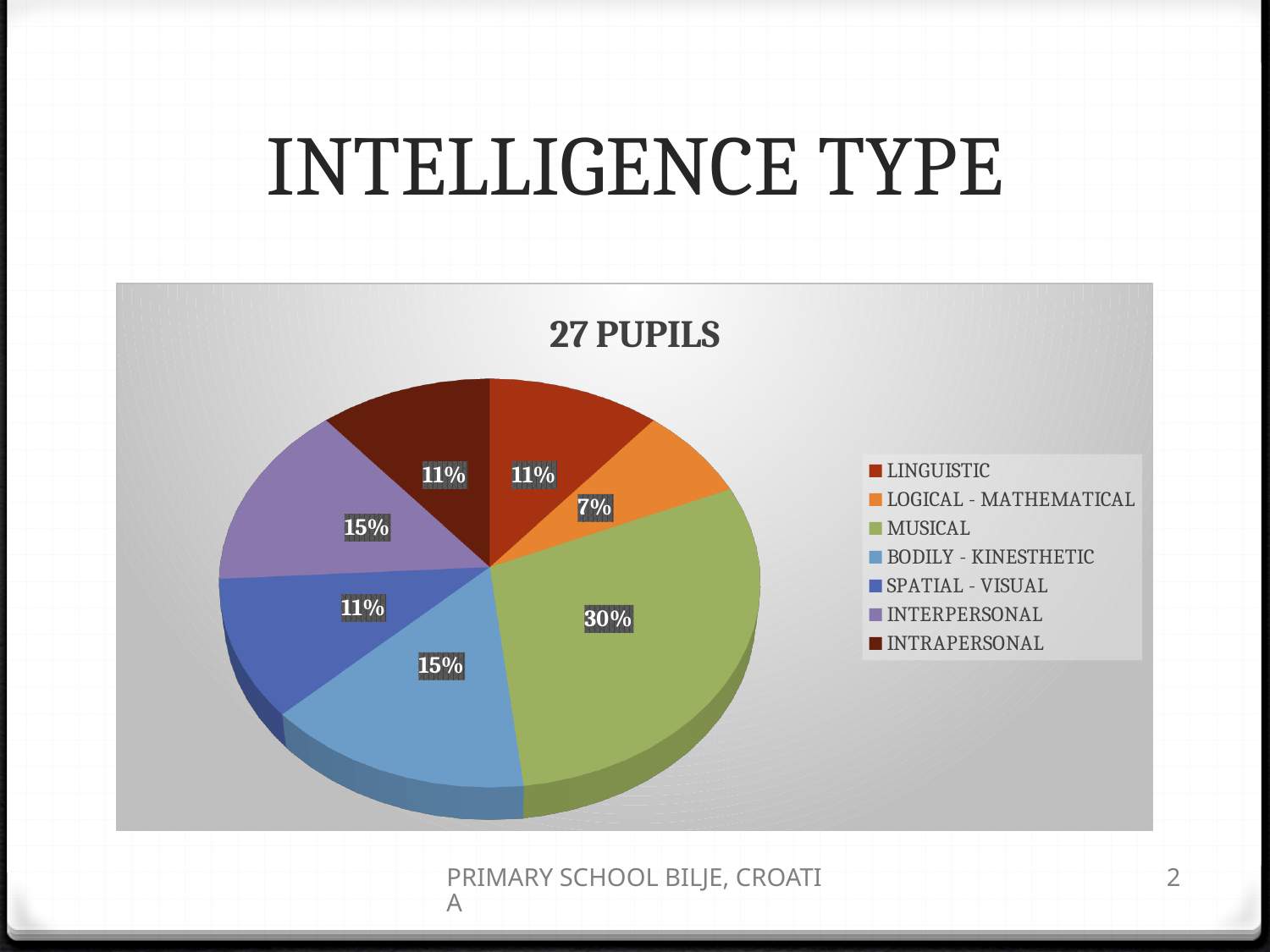
What share of the pie does INTERPERSONAL take? 15% What is the difference in percentage points between MUSICAL and LOGICAL - MATHEMATICAL? 23 What is the title of the chart? 27 PUPILS Which intelligence type has the smallest slice of the pie? LOGICAL - MATHEMATICAL Which intelligence type has the largest slice of the pie? MUSICAL What kind of chart is shown on the slide? pie chart What share of the pie does LINGUISTIC take? 11% What share of the pie does LOGICAL - MATHEMATICAL take? 7% How many slices does the pie chart have? 7 Which is larger, the share for BODILY - KINESTHETIC or the share for SPATIAL - VISUAL? BODILY - KINESTHETIC